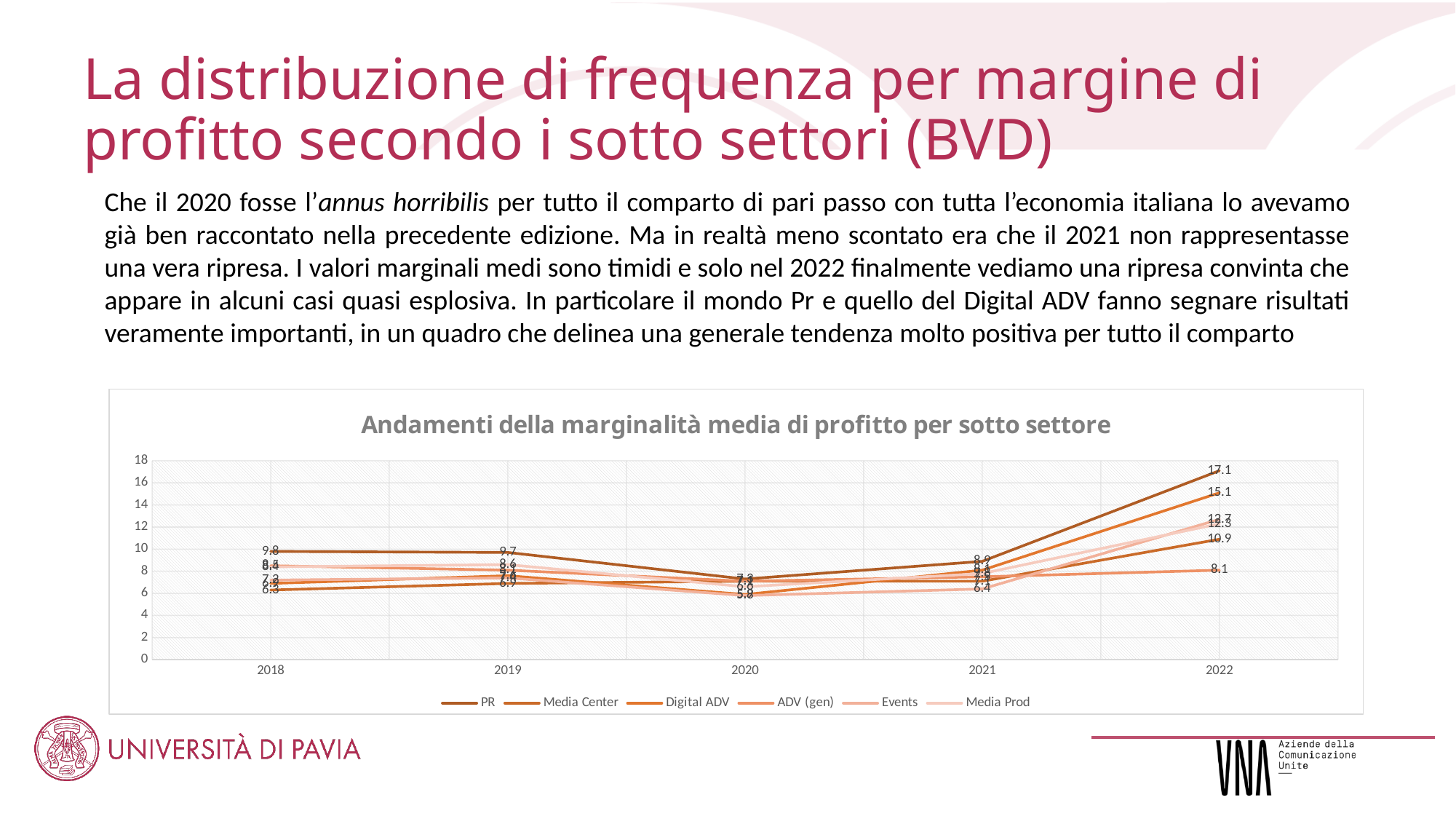
What is the value for PR in 2018? 9.8 How many series does the legend of the chart list? 6 What is the value for PR in 2019? 9.7 What is the difference between the PR value in 2022 and in 2018? 7.3 What is the title of the chart? Andamenti della marginalità media di profitto per sotto settore Which series has the highest value in 2022? PR Is the value for PR in 2022 greater or less than 16? greater Which is larger, the PR value in 2018 or in 2019? 2018 What is the value for PR in 2022? 17.1 What type of chart is shown on the slide? line chart Does the PR series rise or fall from 2020 to 2022? rise How many years are shown along the x axis of the chart? 5